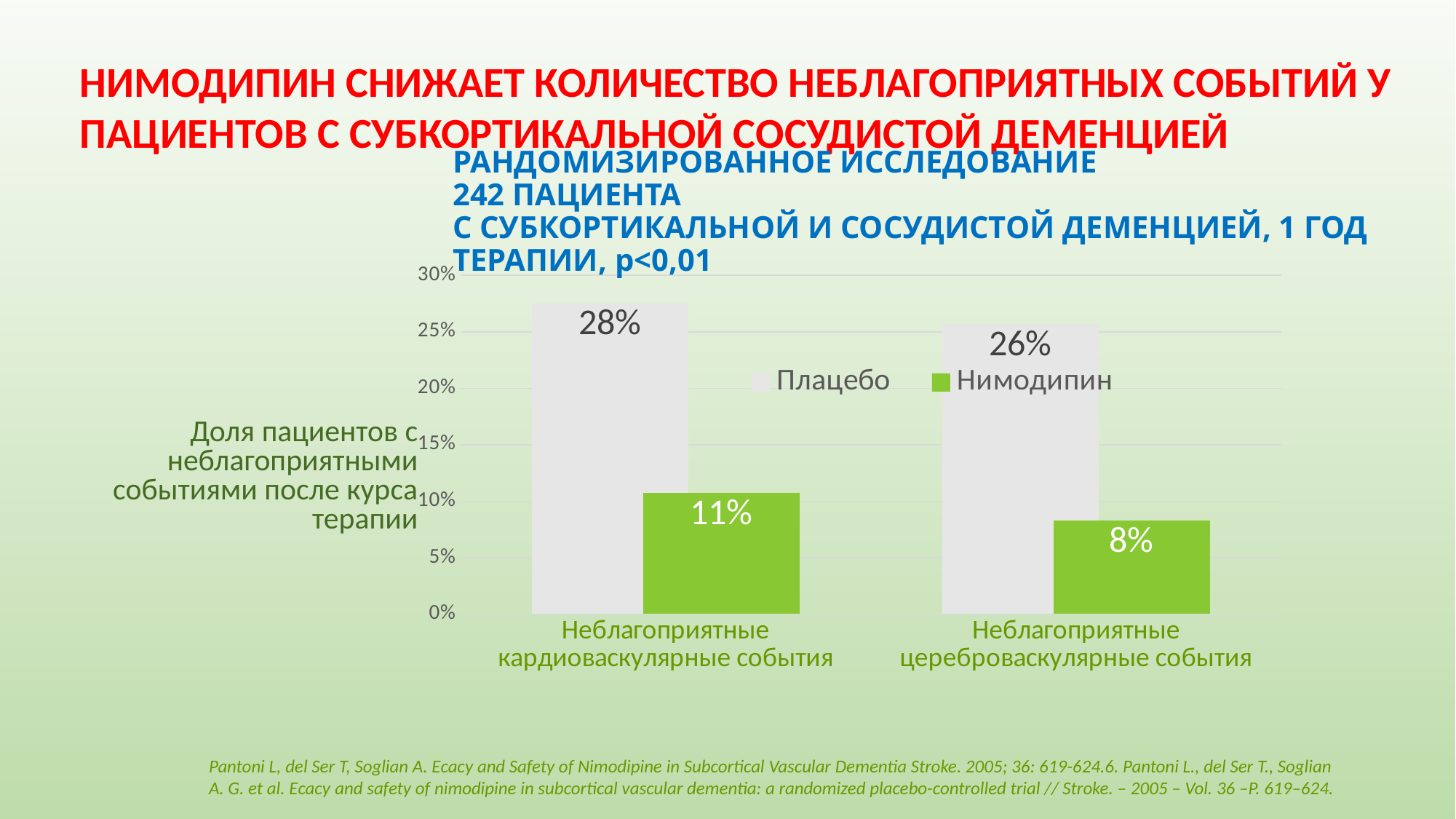
How many series does the legend list? 2 What is the value for Нимодипин in the Неблагоприятные цереброваскулярные события category? 8% Which bar has the highest value on the chart? Плацебо, Неблагоприятные кардиоваскулярные события What is the value for Плацебо in the Неблагоприятные цереброваскулярные события category? 26% What is the value for Плацебо in the Неблагоприятные кардиоваскулярные события category? 28% What is the difference between Плацебо and Нимодипин for Неблагоприятные кардиоваскулярные события? 17% What is the value for Нимодипин in the Неблагоприятные кардиоваскулярные события category? 11% How many categories are shown on the x axis? 2 What is the difference between Плацебо and Нимодипин for Неблагоприятные цереброваскулярные события? 18% What kind of chart is shown on the slide? Bar chart Which is larger for Неблагоприятные цереброваскулярные события: Плацебо or Нимодипин? Плацебо Which bar has the lowest value on the chart? Нимодипин, Неблагоприятные цереброваскулярные события